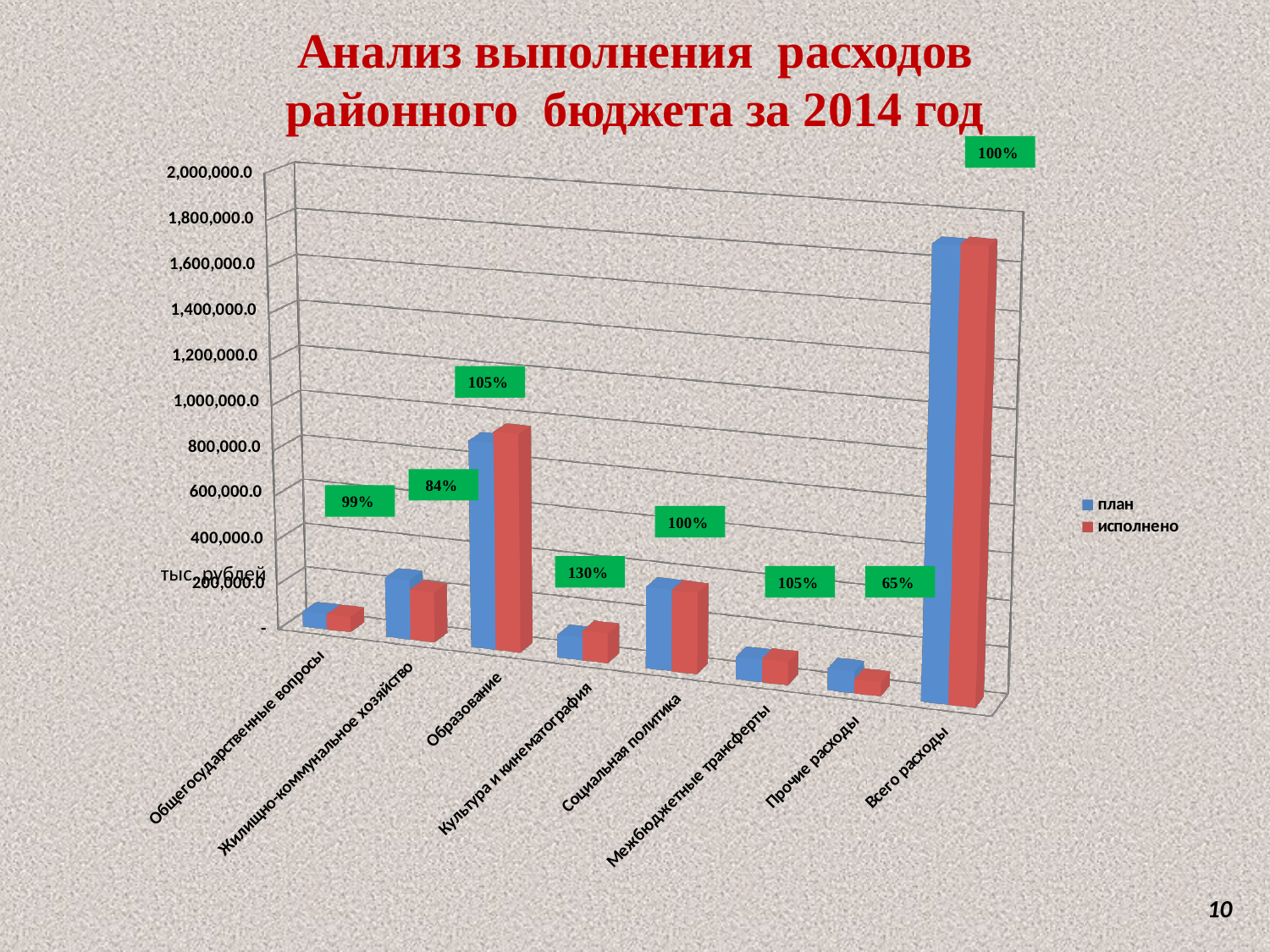
What percentage label is shown above the bars for Образование? 105% How many categories are shown on the x axis? 8 What percentage label is shown above the bars for Жилищно-коммунальное хозяйство? 84% Which category has the highest bars? Всего расходы Which has the larger план value, Образование or Социальная политика? Образование What are the two series named in the legend? план, исполнено What percentage label is shown above the bars for Прочие расходы? 65% What kind of chart is shown on the slide? bar chart Is the план value for Образование greater or less than 600,000.0? greater Is the план value for Всего расходы greater or less than 1,400,000.0? greater How many series does the legend list? 2 What percentage label is shown above the bars for Культура и кинематография? 130%